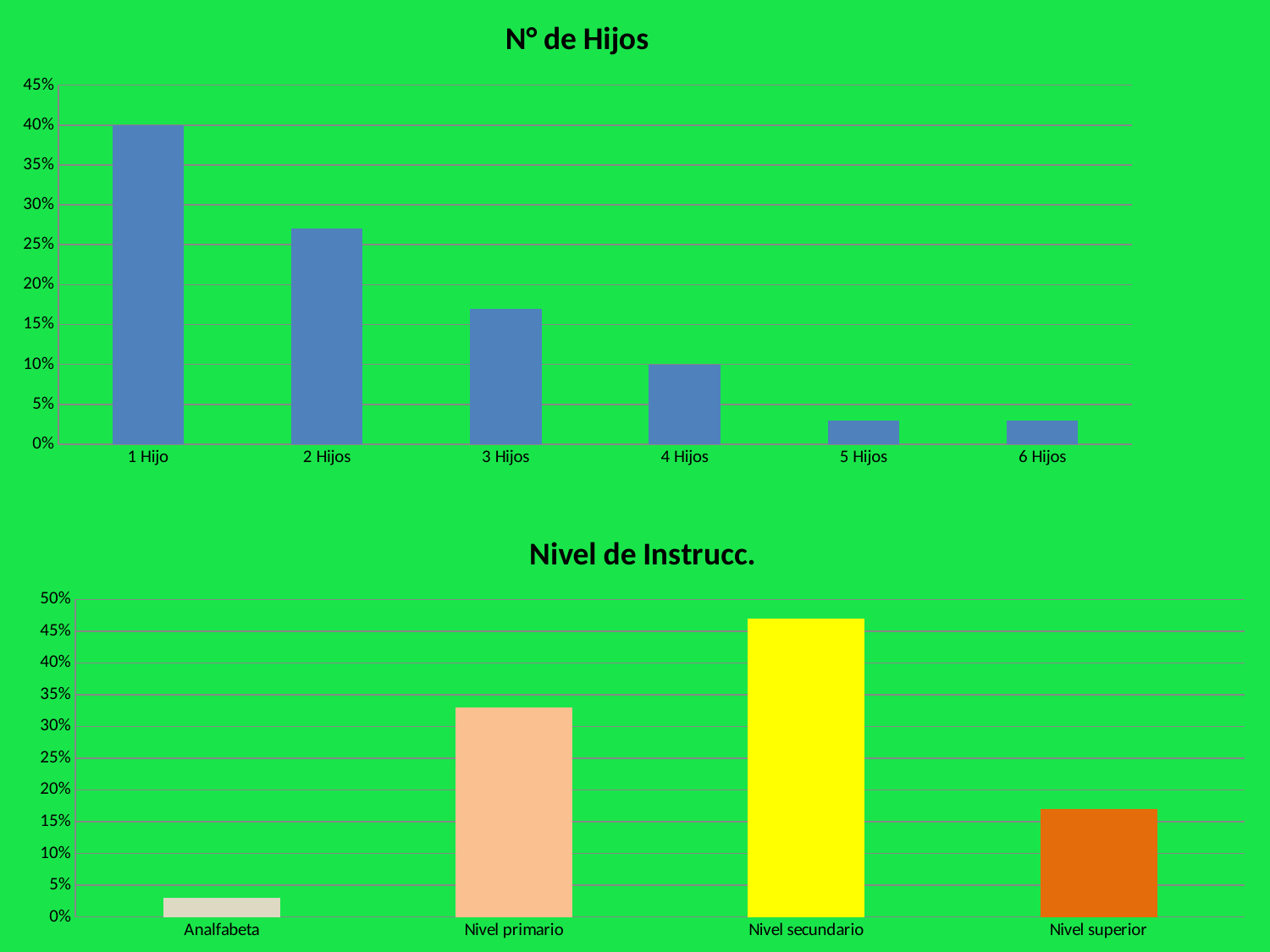
In the 'Nivel de Instrucc.' chart, which category has the lowest value? Analfabeta In the 'Nivel de Instrucc.' chart, which is larger, Nivel primario or Nivel superior? Nivel primario In the 'N° de Hijos' chart, do the values rise or fall from 1 Hijo to 6 Hijos? fall In the 'N° de Hijos' chart, how many categories are shown on the x axis? 6 In the 'Nivel de Instrucc.' chart, is the value for Nivel primario greater or less than 30%? greater In the 'Nivel de Instrucc.' chart, which category has the highest value? Nivel secundario In the 'N° de Hijos' chart, what is the value for 1 Hijo? 40% In the 'N° de Hijos' chart, which category has the highest value? 1 Hijo In the 'N° de Hijos' chart, what is the value for 4 Hijos? 10% In the 'N° de Hijos' chart, is the value for 3 Hijos greater or less than 20%? less What kind of chart is the 'Nivel de Instrucc.' chart? bar chart In the 'N° de Hijos' chart, is the value for 2 Hijos greater or less than 25%? greater